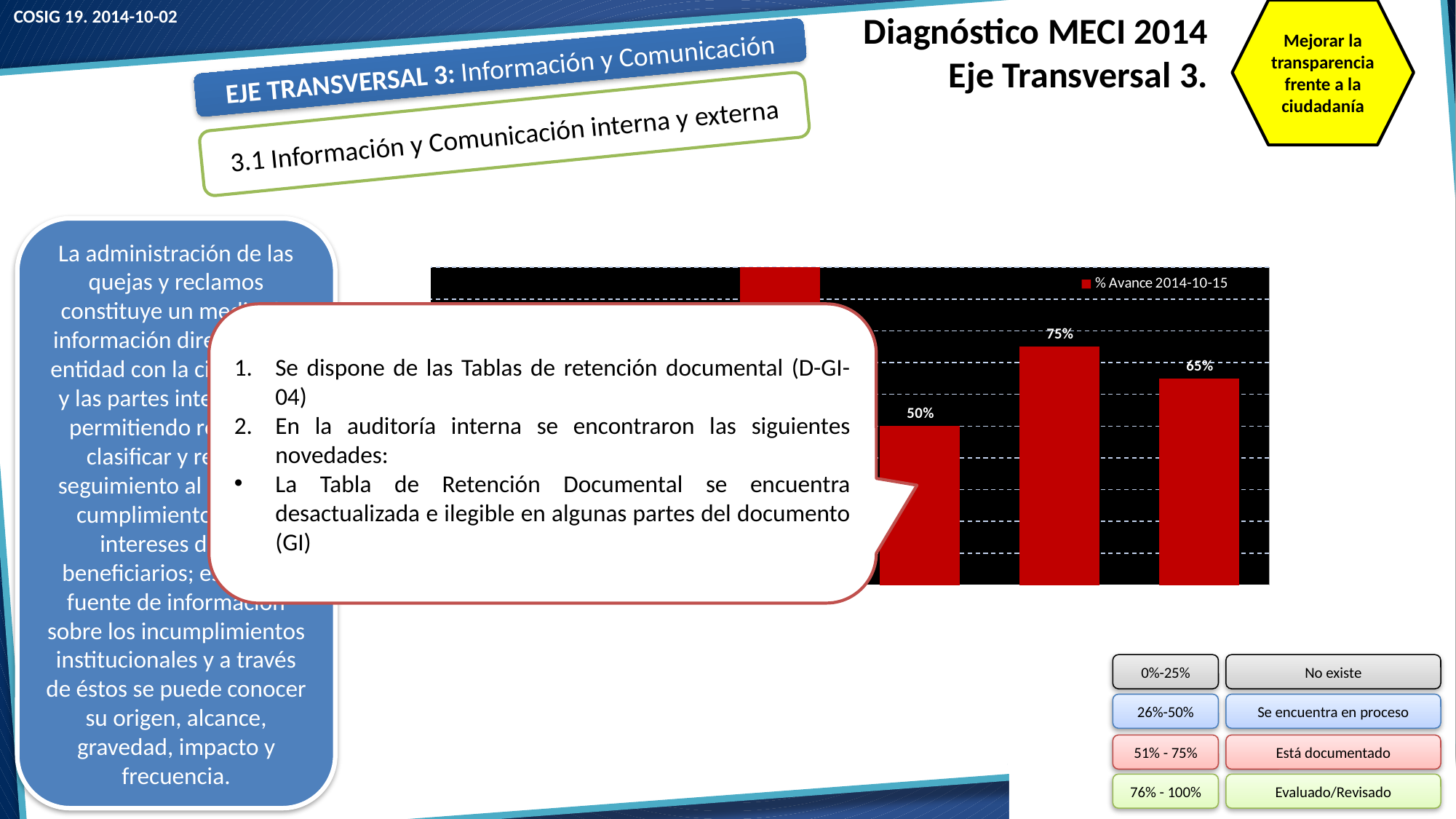
Among the three bars with visible data labels (50%, 75%, 65%), which value is the highest? 75% Is the bar labelled 65% taller or shorter than the bar labelled 75%? shorter Among the three bars with visible data labels (50%, 75%, 65%), which value is the lowest? 50% How many series does the chart legend list? 1 What colour are the bars in the chart? red What kind of chart is shown on the slide? bar chart What is the difference between the bars labelled 75% and 65%? 10% What is the name of the series shown in the chart legend? % Avance 2014-10-15 What is the difference between the bars labelled 75% and 50%? 25%